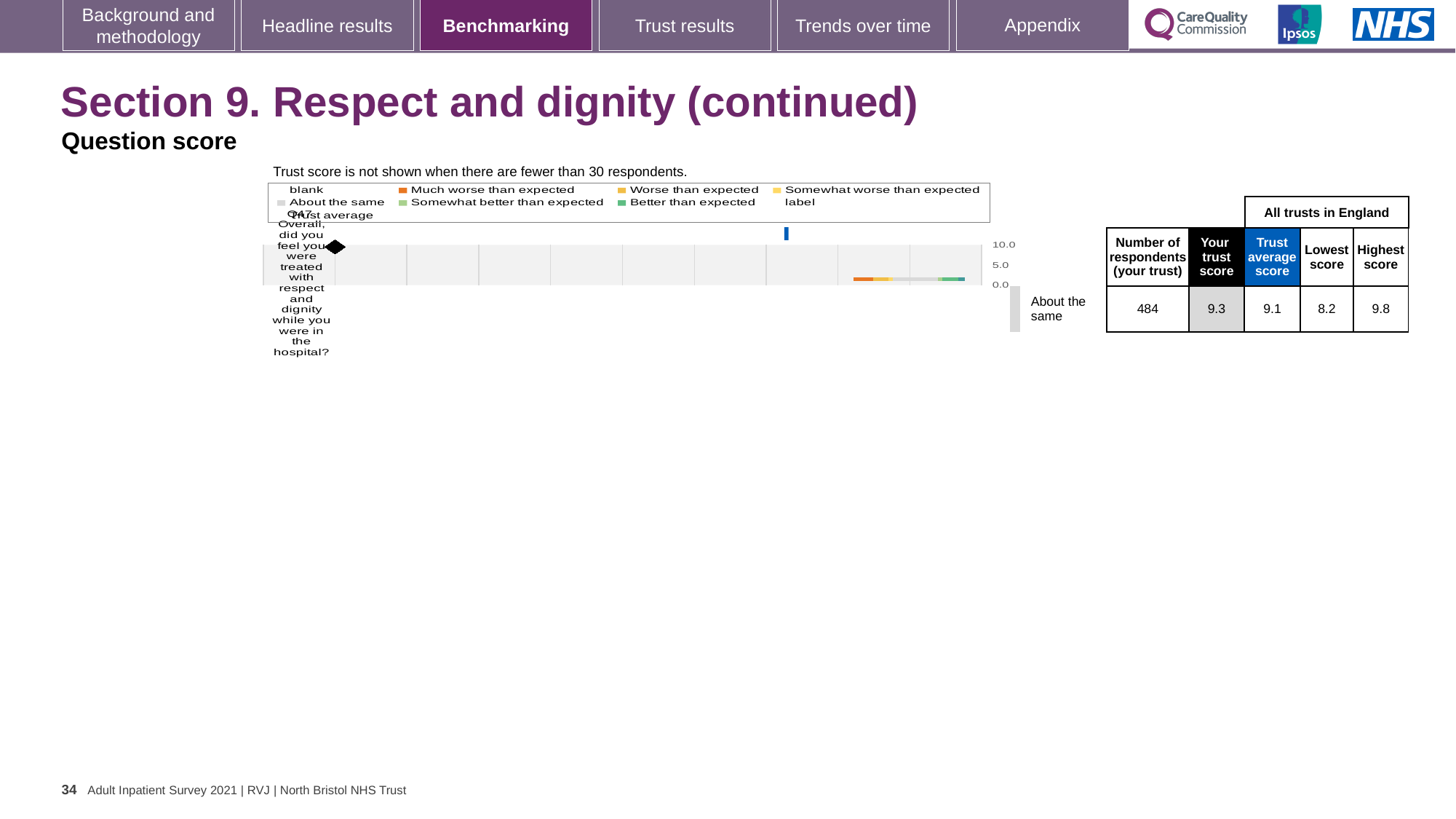
According to the table beside the chart, what is the lowest score among all trusts in England for Q47? 8.2 What is the question number of the item plotted on the chart? Q47 According to the table beside the chart, what is the trust average score for Q47? 9.1 How many questions (categories) are plotted on the chart? 1 What kind of chart is shown on the slide for Section 9 Respect and dignity? bar chart Is the trust score for Q47 greater or less than 5.0 on the chart's axis? greater Which is larger for Q47: the trust score or the trust average score? the trust score (9.3) According to the table beside the chart, what is the trust score for Q47? 9.3 What is the difference between the highest score (9.8) and the lowest score (8.2) for Q47? 1.6 What benchmark category label is shown next to the chart for Q47? About the same How many respondents from the trust answered Q47? 484 According to the table beside the chart, what is the highest score among all trusts in England for Q47? 9.8